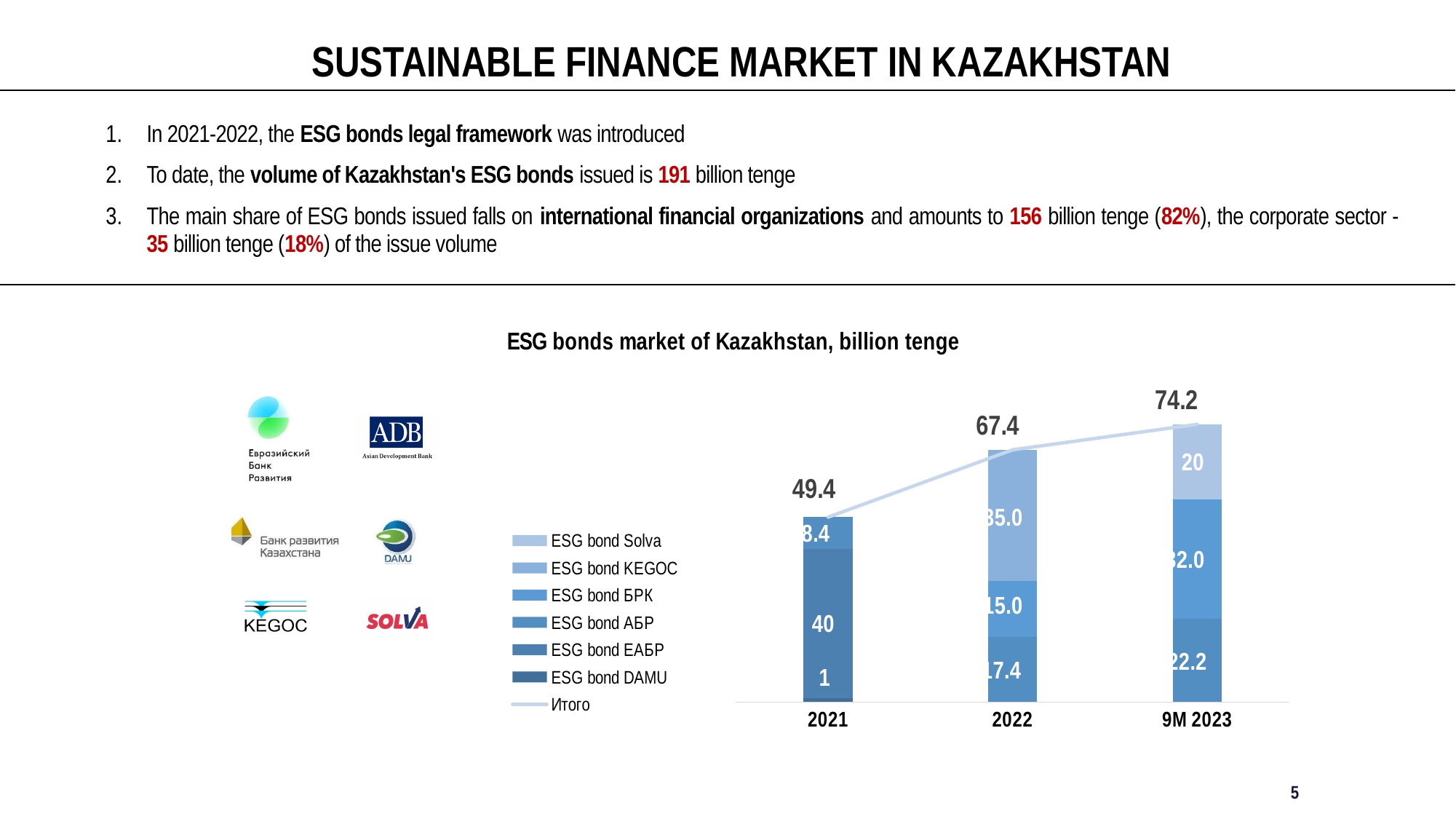
What is the total value shown for 9M 2023 in the ESG bonds market chart? 74.2 Is the total for 2022 larger or smaller than the total for 2021 in the ESG bonds market chart? larger How many entries does the legend of the ESG bonds market chart list? 7 Do the totals in the ESG bonds market chart rise or fall from 2021 to 9M 2023? rise What is the total value shown for 2021 in the ESG bonds market chart? 49.4 Which period has the lowest total in the ESG bonds market chart? 2021 Which period has the highest total in the ESG bonds market chart? 9M 2023 What is the total value shown for 2022 in the ESG bonds market chart? 67.4 What is the title of the chart on the slide? ESG bonds market of Kazakhstan, billion tenge How many categories are shown on the x axis of the ESG bonds market chart? 3 What type of chart is used to show the ESG bonds market of Kazakhstan? Stacked bar chart with a line What is the difference between the totals for 9M 2023 and 2022 in the ESG bonds market chart? 6.8